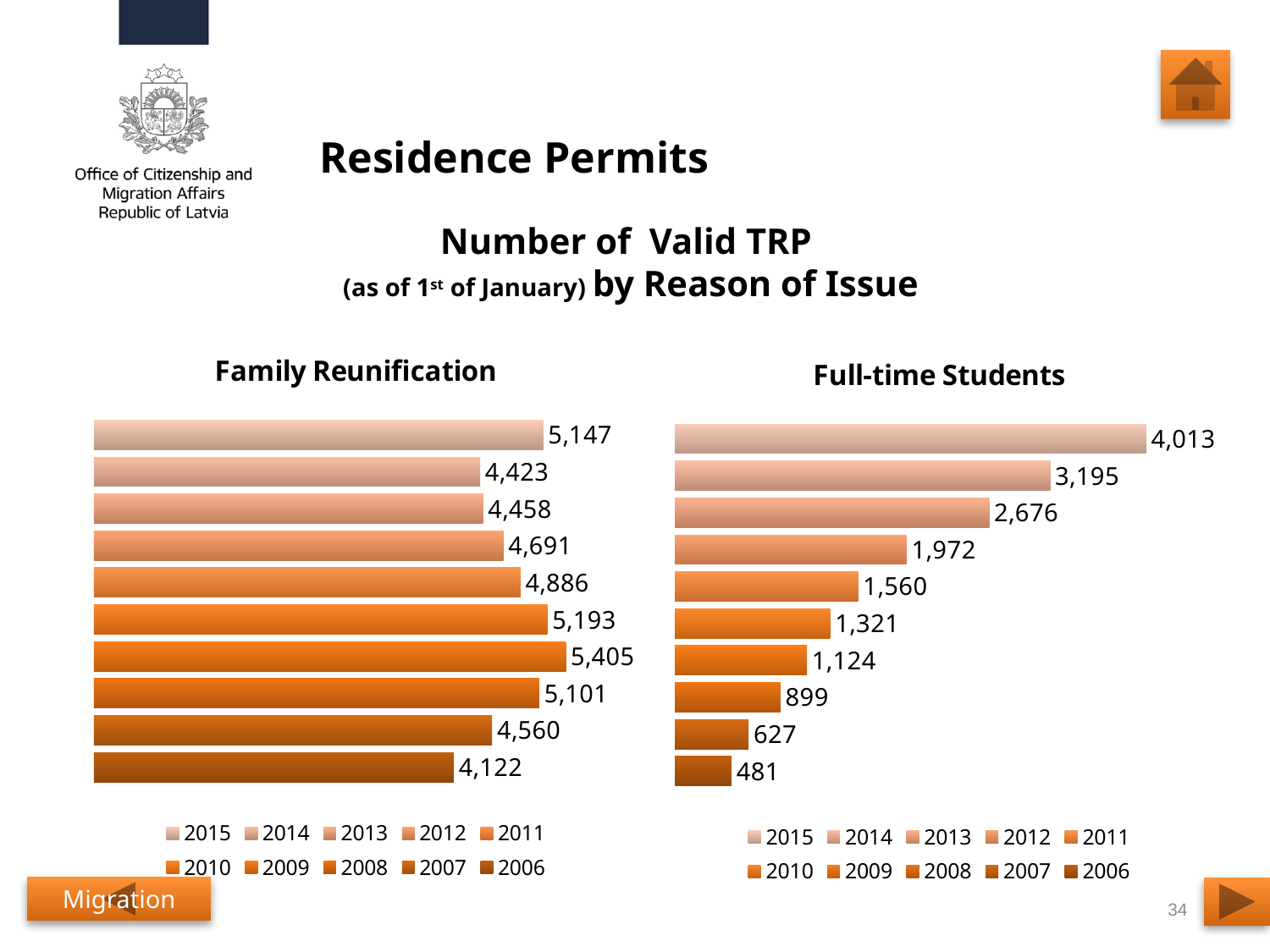
In the Family Reunification chart, which is larger: the 2015 value or the 2014 value? 2015 In the Family Reunification chart, what is the value of the top bar (2015)? 5,147 In the Full-time Students chart, do the values rise or fall going from 2006 to 2015? Rise In the Family Reunification chart, what is the difference between the 2009 value (5,405) and the 2006 value (4,122)? 1,283 How many bars are shown in the Full-time Students chart? 10 In the Family Reunification chart, which year has the lowest value? 2006 In the Full-time Students chart, what is the value of the bottom bar (2006)? 481 How many series does the legend of the Family Reunification chart list? 10 In the Family Reunification chart, which year has the highest value? 2009 In the Full-time Students chart, what is the difference between the 2015 value (4,013) and the 2014 value (3,195)? 818 What type of chart is the Full-time Students chart? Bar chart In the Full-time Students chart, which year has the highest value? 2015